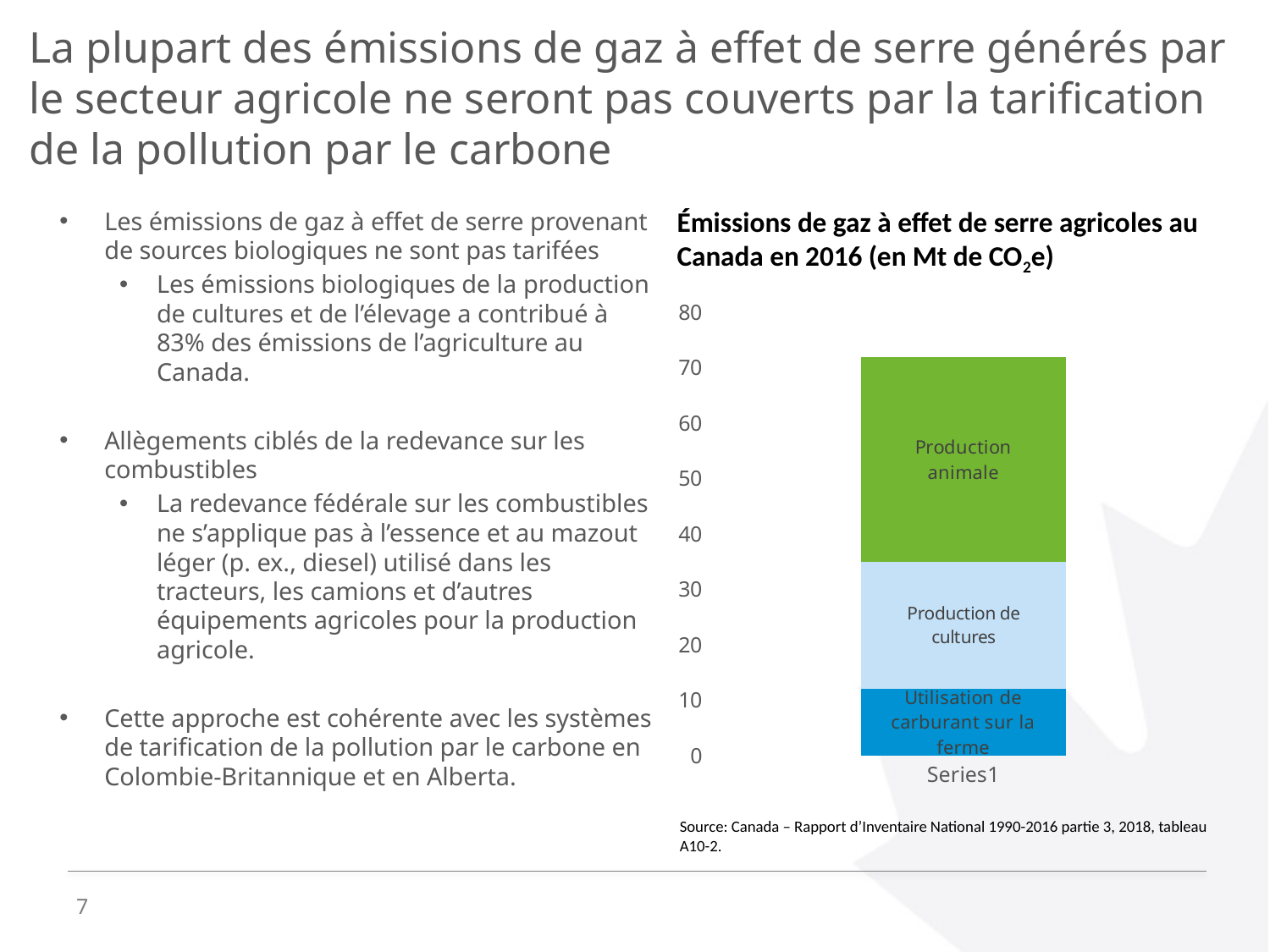
What is the title of the chart? Émissions de gaz à effet de serre agricoles au Canada en 2016 (en Mt de CO2e) Is the boundary between the Production de cultures and Production animale segments greater or less than 30? greater Which segment of the stacked bar is the largest? Production animale Is the total height of the stacked bar greater or less than 80? less What label appears under the bar on the x axis? Series1 Which segment is larger, Production animale or Production de cultures? Production animale Is the total height of the stacked bar greater or less than 60? greater What kind of chart is shown on the slide? stacked bar chart Which segment of the stacked bar is the smallest? Utilisation de carburant sur la ferme How many segments make up the stacked bar in the chart? 3 Which segment is larger, Production de cultures or Utilisation de carburant sur la ferme? Production de cultures